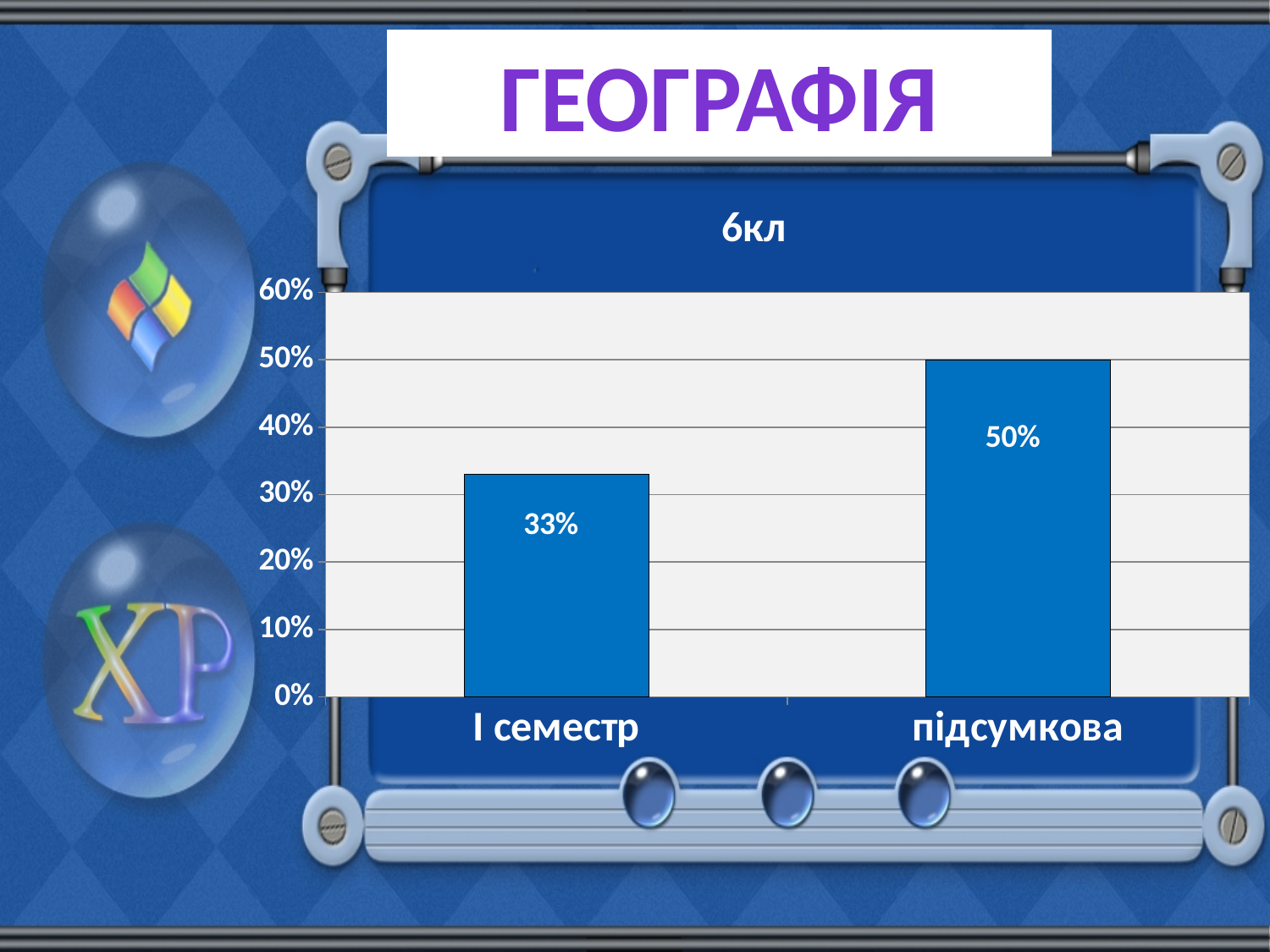
Is the value for підсумкова greater or less than 40%? greater What kind of chart is shown on the slide? bar chart What is the title of the chart? 6кл Which category has the highest value? підсумкова Do the values rise or fall from І семестр to підсумкова? rise How many categories are shown on the x axis? 2 What is the value for І семестр? 33% Is the value for І семестр greater or less than 40%? less What is the difference between the values for підсумкова and І семестр? 17% What is the value for підсумкова? 50% Which is larger, the value for І семестр or the value for підсумкова? підсумкова Which category has the lowest value? І семестр